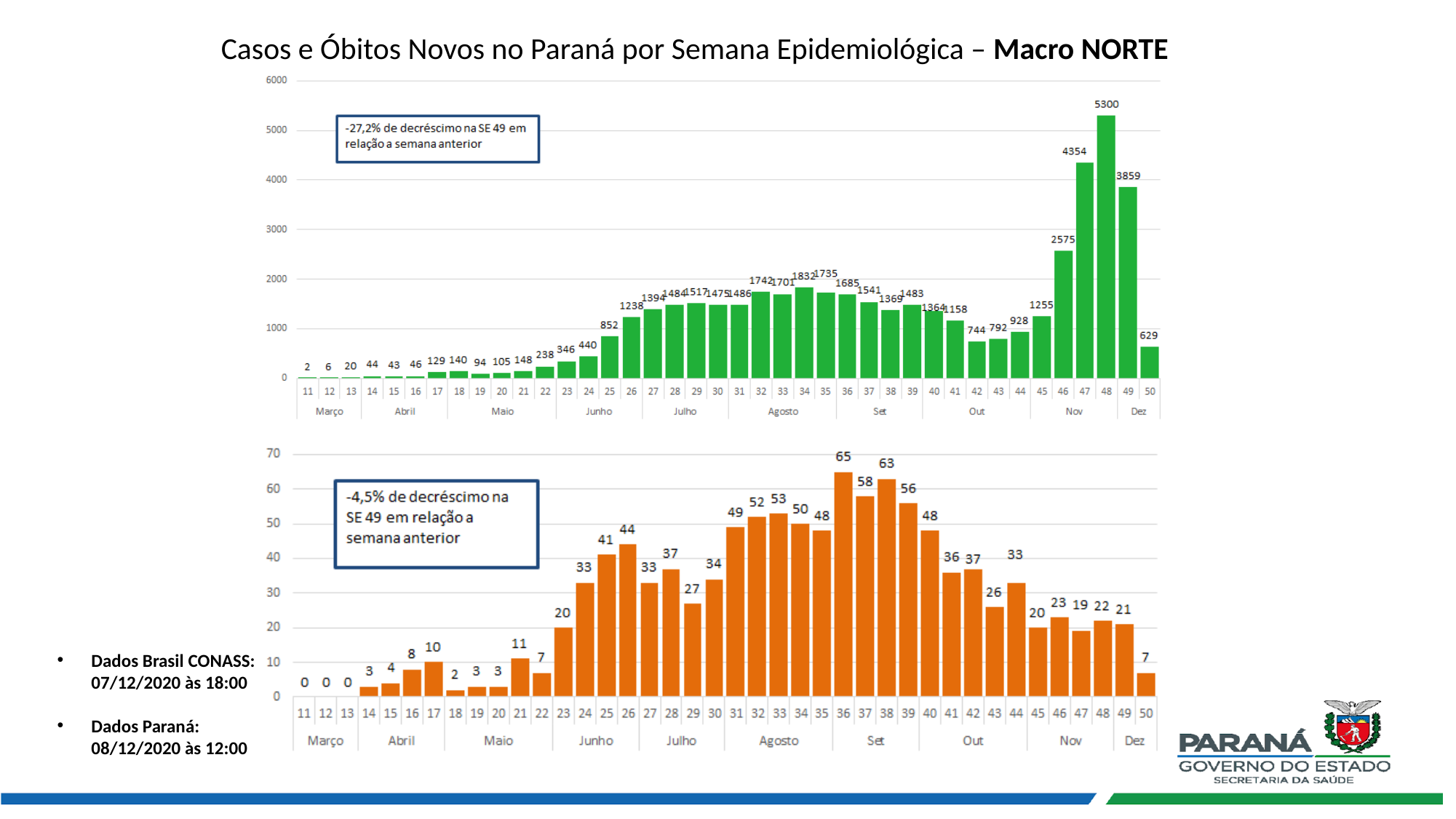
In the top (green) chart, is the value for week 46 greater or less than 2000? greater In the bottom (orange) chart, which is larger, the value for week 38 or the value for week 37? week 38 In the top (green) chart, what is the value for week 48? 5300 In the top (green) chart, what is the difference between the values for week 48 and week 49? 1441 In the top (green) chart, which week has the highest value? 48 What kind of chart is the bottom (orange) chart? bar chart In the bottom (orange) chart, what is the value for week 50? 7 In the bottom (orange) chart, what is the value for week 36? 65 In the bottom (orange) chart, what is the difference between the values for week 48 and week 49? 1 How many weeks (bars) are shown in the top (green) chart? 40 In the bottom (orange) chart, which week has the highest value? 36 In the top (green) chart, what is the value for week 50? 629